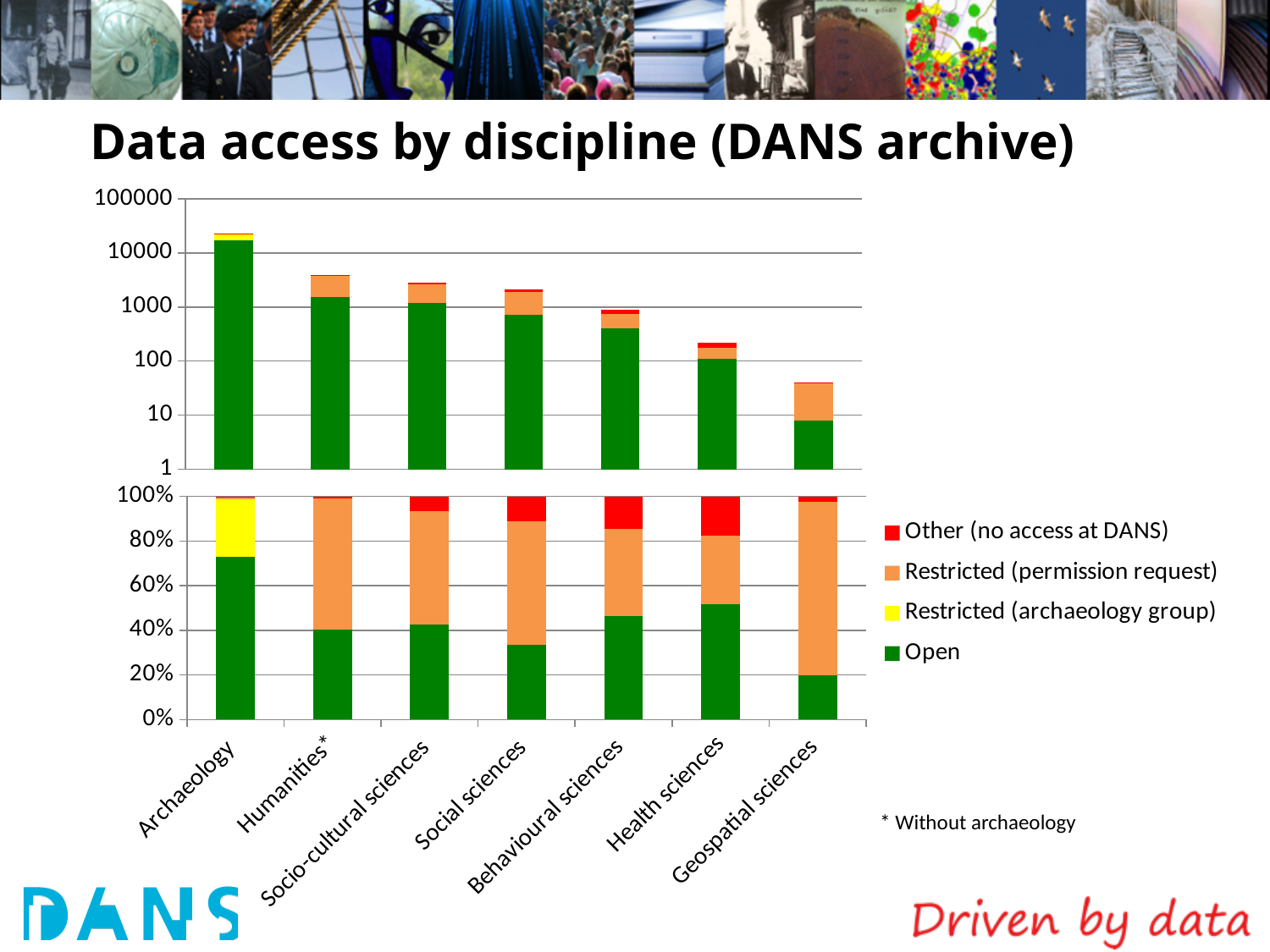
In the bottom chart, is the Open share for Archaeology greater or less than 60%? greater How many discipline categories are shown on the x axis of the bottom chart? 7 In the bottom chart, is the Open share for Social sciences greater or less than 40%? less In the top chart, is the Open value for Archaeology greater or less than 10000? greater In the bottom chart, which has the larger Open share: Health sciences or Social sciences? Health sciences In the top chart, which discipline has the highest total number of datasets? Archaeology What kind of chart is the top chart on the slide? Stacked bar chart In the bottom chart, which discipline is the only one with a 'Restricted (archaeology group)' segment? Archaeology How many series does the legend list? 4 In the top chart, which discipline has the lowest total number of datasets? Geospatial sciences In the top chart, do the bar totals rise or fall from left to right along the x axis? Fall